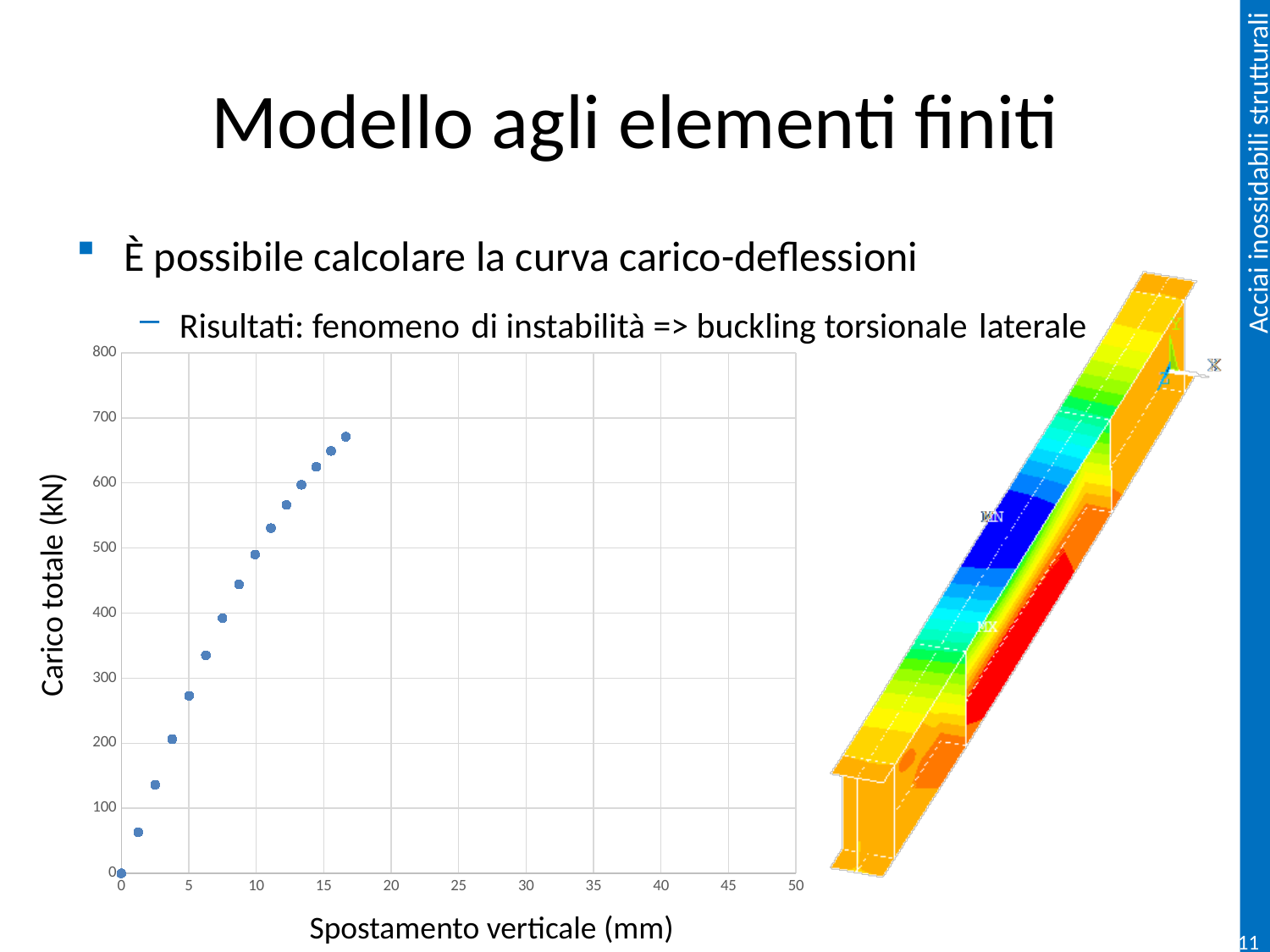
Do the plotted values rise or fall as the vertical displacement increases along the x axis? rise What is the title of the vertical axis of the chart? Carico totale (kN) Is the load at a vertical displacement of 10 mm greater or less than 400 kN? greater Is the highest plotted load value greater or less than 600 kN? greater What is the title of the horizontal axis of the chart? Spostamento verticale (mm) What kind of chart is shown on the slide? scatter chart Is the largest vertical displacement plotted greater or less than 20 mm? less What is the maximum value shown on the vertical axis of the chart? 800 What is the load value of the first point, at 0 mm vertical displacement? 0